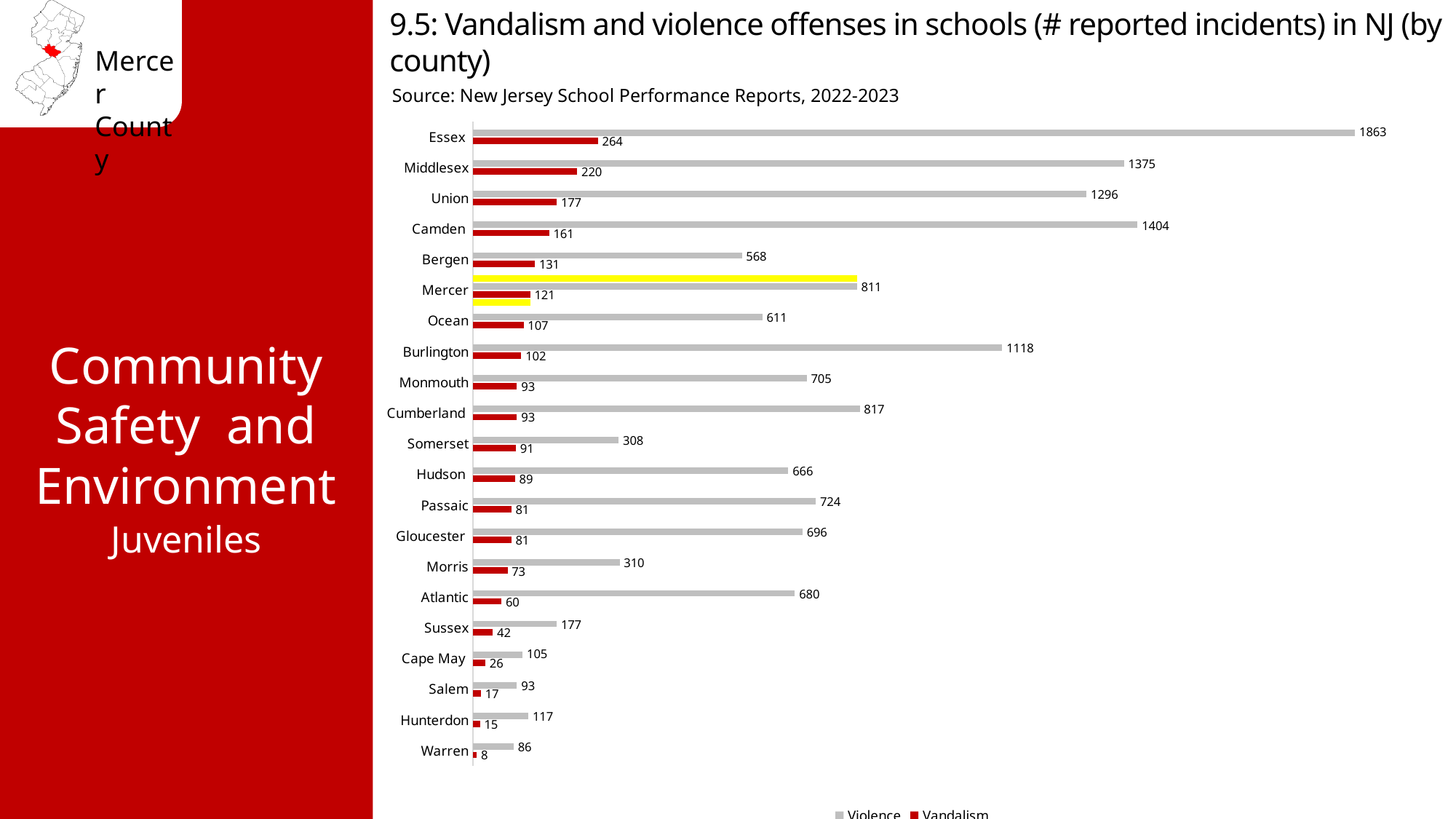
What is the number of reported violence incidents for Burlington? 1118 Which county has more vandalism incidents, Middlesex or Union? Middlesex What kind of chart is shown on the slide? bar chart What is the difference between the vandalism incidents for Mercer and Bergen? 10 Which county has the highest number of violence incidents? Essex Which county has the lowest number of vandalism incidents? Warren Which series is shown in red on the chart? Vandalism How many counties are listed on the chart? 21 What is the difference between the violence incidents for Camden and Union? 108 What is the number of reported vandalism incidents for Essex? 264 How many series does the legend list? 2 What is the number of reported violence incidents for Mercer? 811